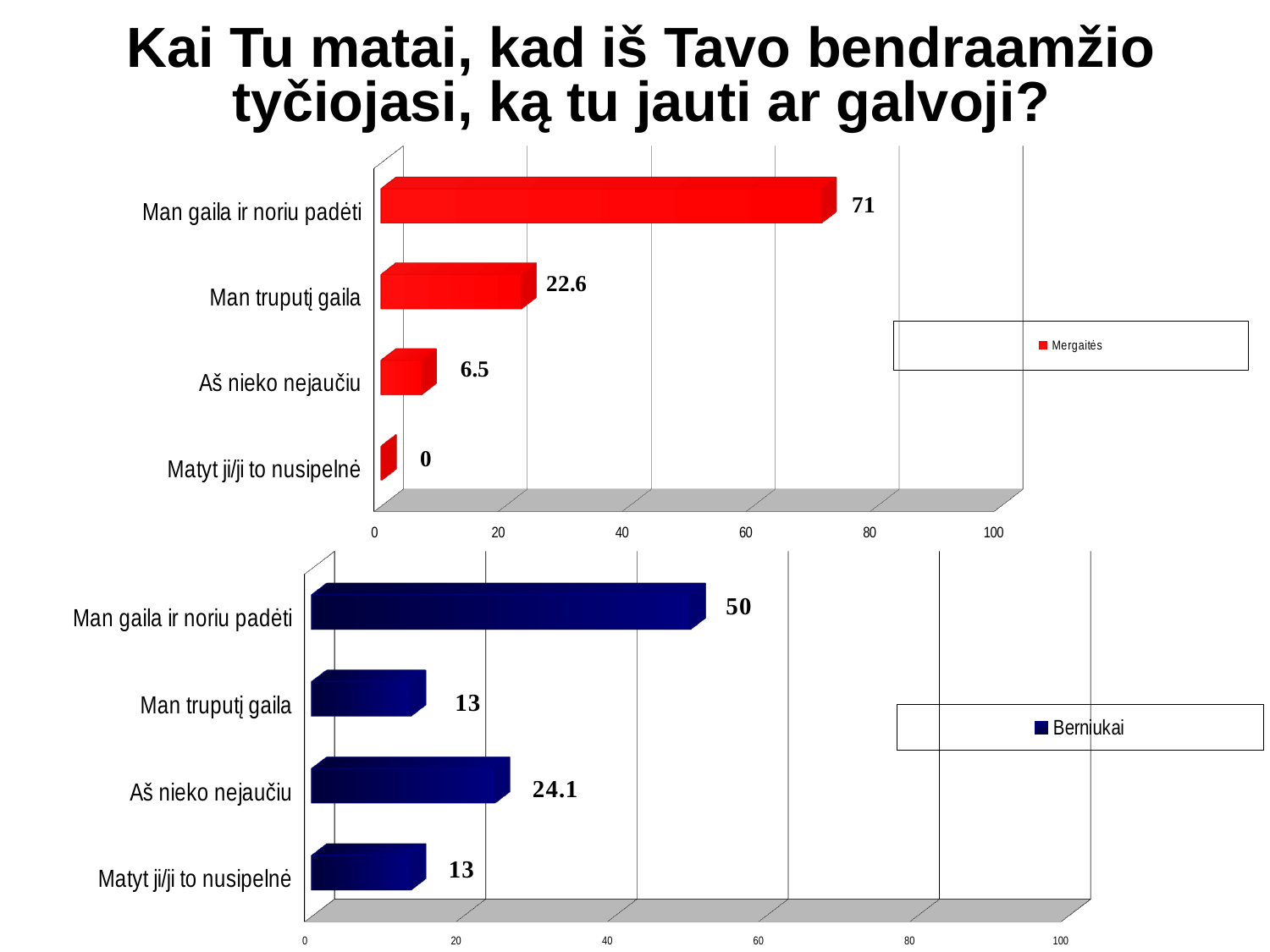
In the top chart (Mergaitės), what is the value for "Man gaila ir noriu padėti"? 71 In the top chart (Mergaitės), which category has the lowest value? Matyt ji/ji to nusipelnė In the top chart (Mergaitės), what is the value for "Man truputį gaila"? 22.6 In the bottom chart (Berniukai), what is the value for "Aš nieko nejaučiu"? 24.1 In the top chart (Mergaitės), what is the value for "Aš nieko nejaučiu"? 6.5 In the bottom chart (Berniukai), which category has the highest value? Man gaila ir noriu padėti In the top chart (Mergaitės), what is the difference between "Man gaila ir noriu padėti" and "Man truputį gaila"? 48.4 In the bottom chart (Berniukai), which is larger: "Man truputį gaila" or "Aš nieko nejaučiu"? Aš nieko nejaučiu In the bottom chart (Berniukai), what is the value for "Man gaila ir noriu padėti"? 50 In the bottom chart (Berniukai), what is the difference between "Man gaila ir noriu padėti" and "Aš nieko nejaučiu"? 25.9 How many categories does the top chart (Mergaitės) show? 4 What type of chart is the bottom chart (Berniukai)? Bar chart